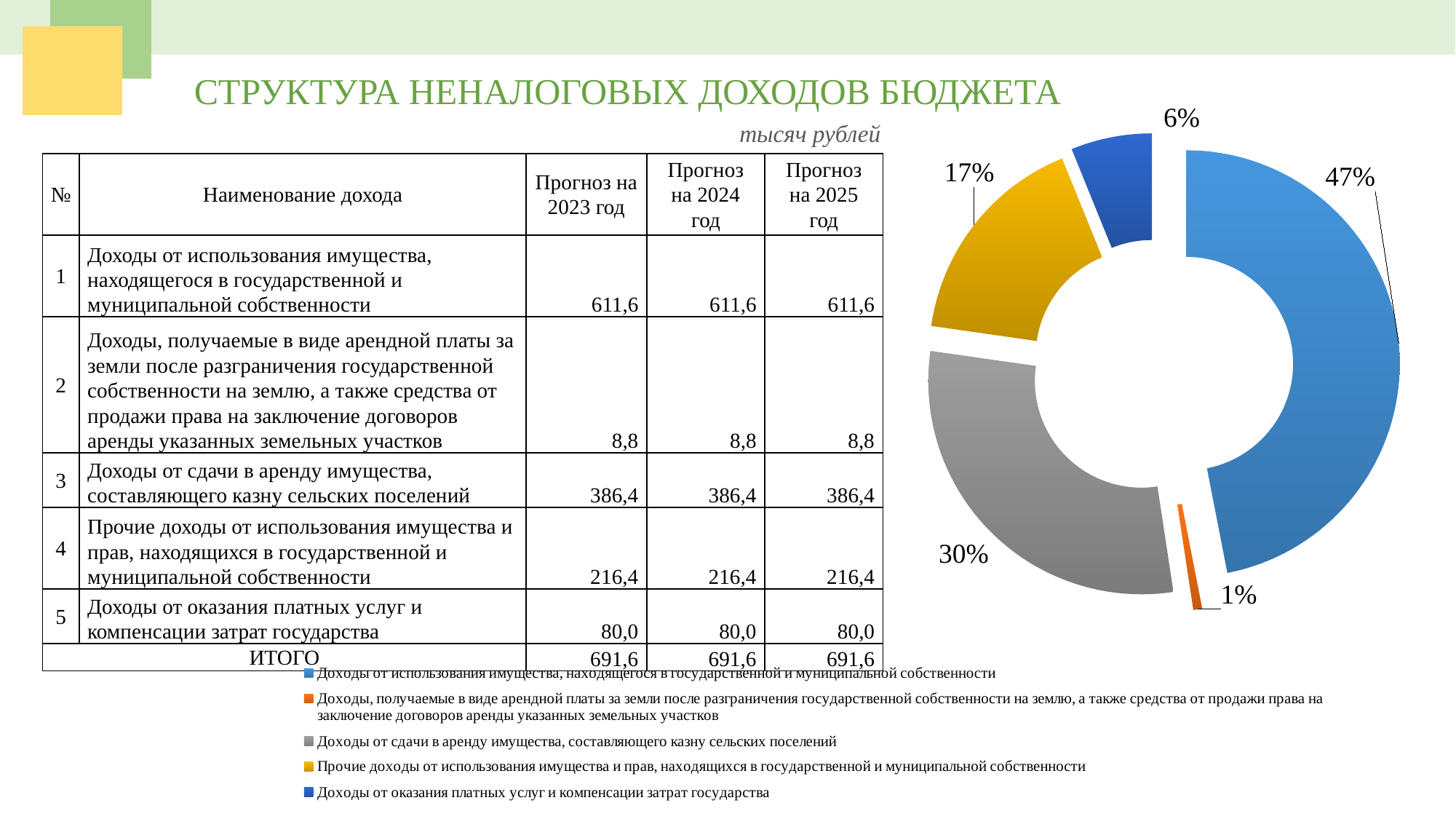
How many entries does the chart legend list? 5 What share of the doughnut chart is labelled for 'Доходы от оказания платных услуг и компенсации затрат государства'? 6% How many slices does the doughnut chart have? 5 What share of the doughnut chart is labelled for 'Доходы от использования имущества, находящегося в государственной и муниципальной собственности'? 47% What colour is the slice for 'Доходы от сдачи в аренду имущества, составляющего казну сельских поселений' in the doughnut chart? Gray What share of the doughnut chart is labelled for 'Прочие доходы от использования имущества и прав, находящихся в государственной и муниципальной собственности'? 17% What kind of chart is shown on the slide? Doughnut (pie) chart Which category has the largest slice in the doughnut chart? Доходы от использования имущества, находящегося в государственной и муниципальной собственности By how many percentage points does the 47% slice exceed the 30% slice in the doughnut chart? 17